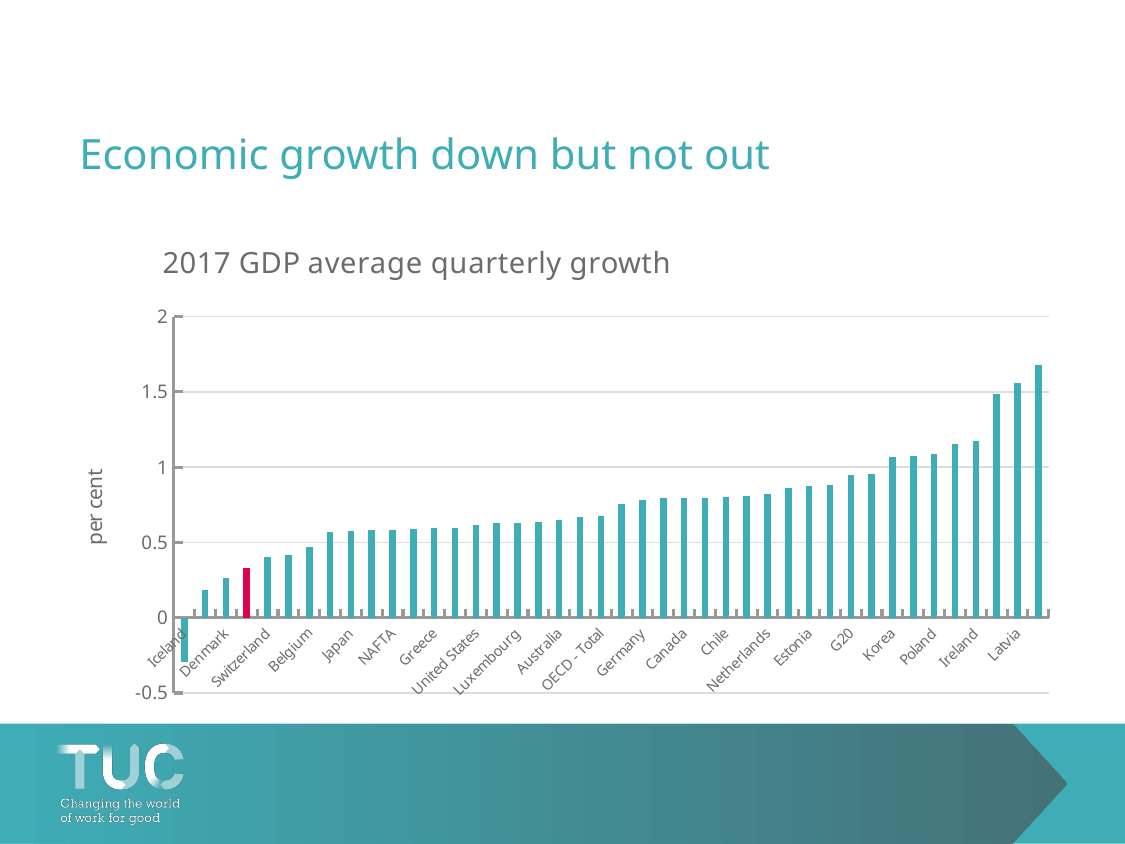
Do the bar values rise or fall moving from left to right along the x axis? rise What is the title of the chart? 2017 GDP average quarterly growth Is the value for Iceland greater or less than 0? less Which labelled country has the highest 2017 GDP average quarterly growth? Latvia Is the value for Germany greater or less than 1? less Is the value for Denmark greater or less than 0.5? less Which labelled country has the lowest 2017 GDP average quarterly growth? Iceland What is the label on the vertical axis of the chart? per cent Which has the higher 2017 GDP average quarterly growth, Germany or Japan? Germany What kind of chart is shown on the slide? bar chart